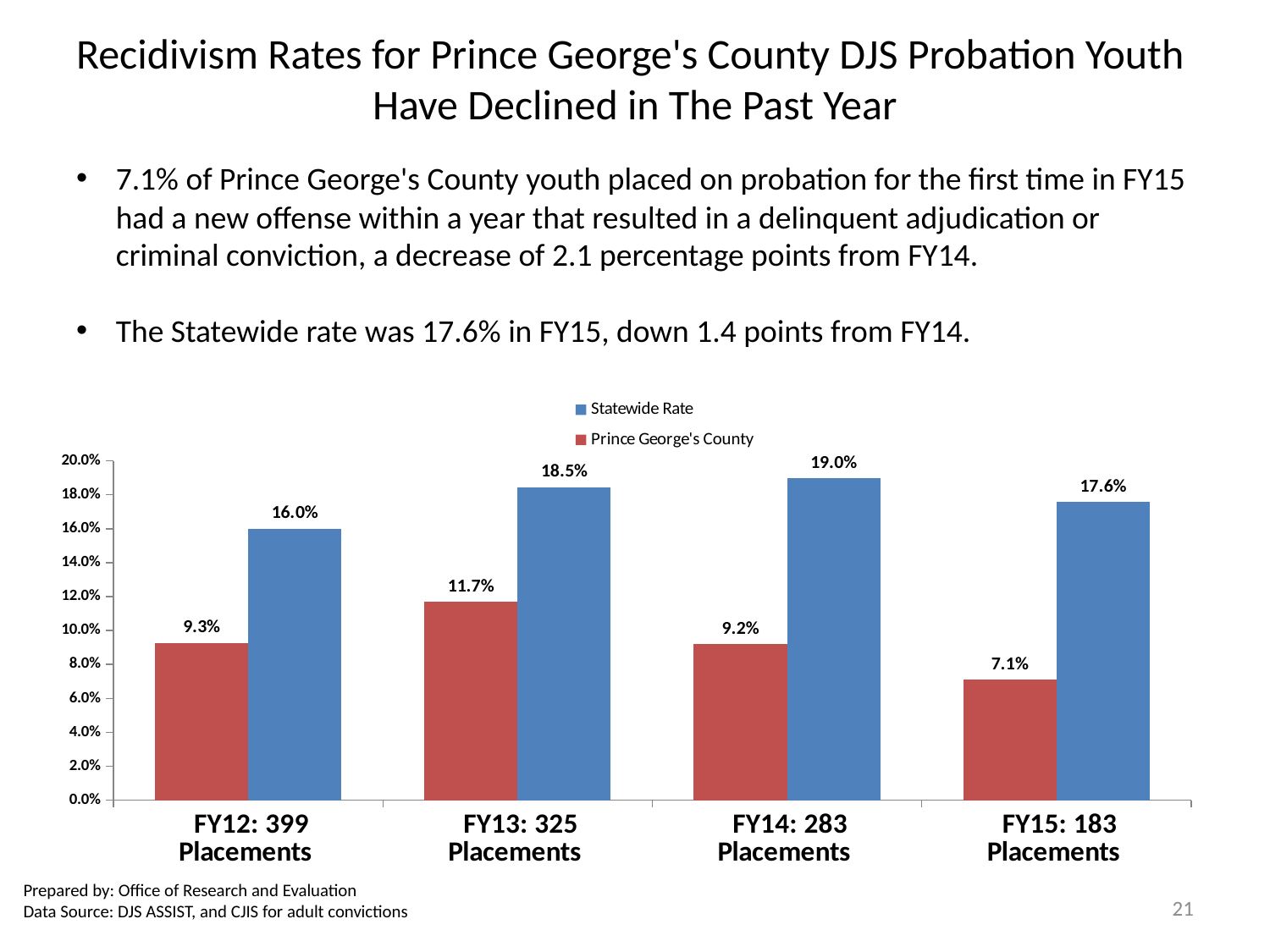
Is the Prince George's County rate for FY13: 325 Placements greater or less than 10.0%? greater Which colour represents the Statewide Rate in the chart? Blue What is the Statewide Rate for FY13: 325 Placements? 18.5% What kind of chart is shown on the slide? Bar chart How many series does the legend list? 2 In which fiscal year is the Prince George's County rate lowest? FY15: 183 Placements Which is larger for FY13: 325 Placements, the Statewide Rate or the Prince George's County rate? Statewide Rate What is the Prince George's County recidivism rate for FY15: 183 Placements? 7.1% What is the Prince George's County rate for FY12: 399 Placements? 9.3% How many fiscal year categories are shown on the x axis? 4 What is the difference between the Statewide Rate and the Prince George's County rate for FY14: 283 Placements? 9.8 percentage points In which fiscal year is the Statewide Rate highest? FY14: 283 Placements